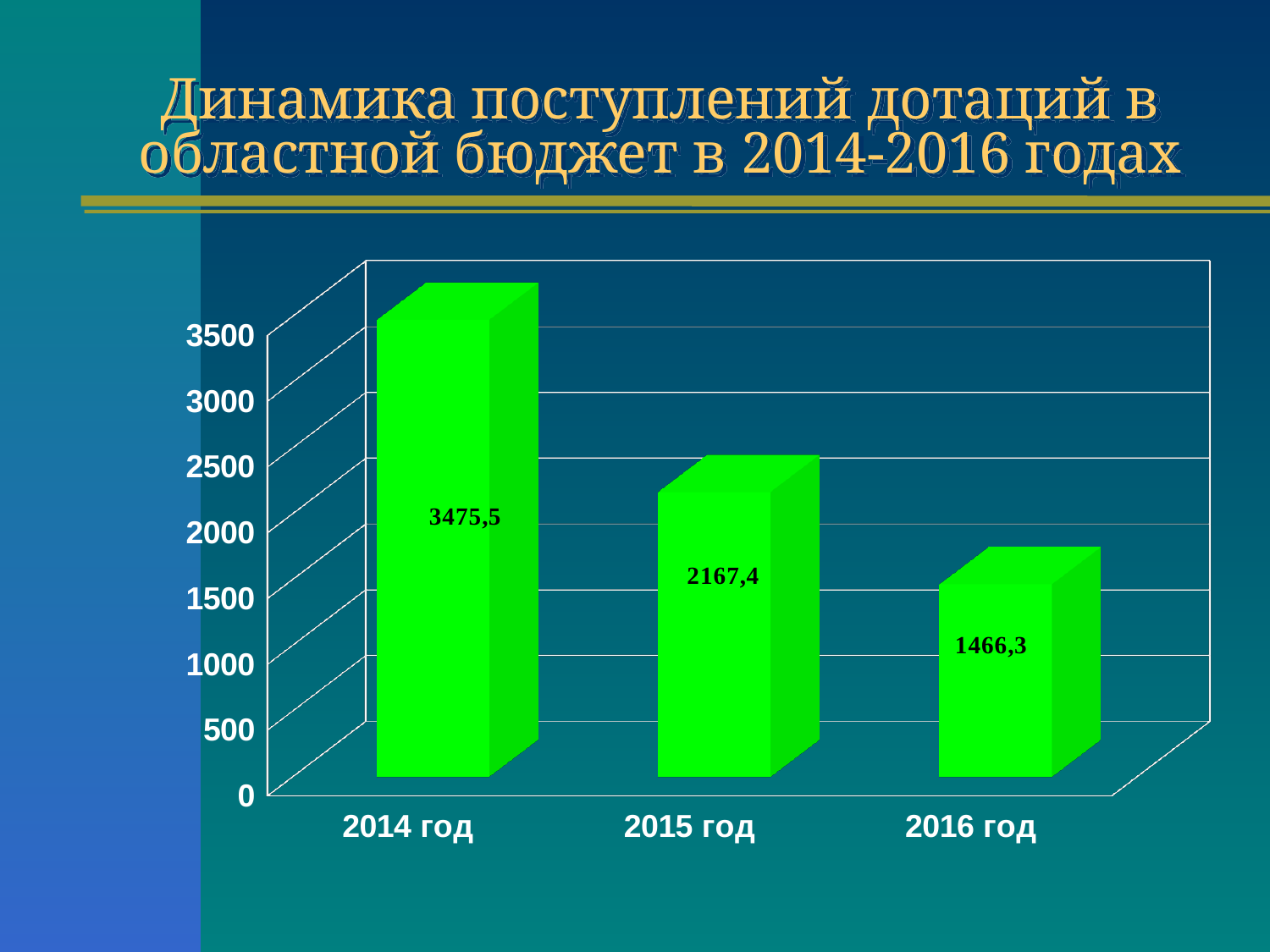
Which year has the highest value? 2014 год What is the difference between the values for 2015 год and 2016 год? 701,1 Which is larger, the value for 2015 год or the value for 2016 год? 2015 год What is the difference between the values for 2014 год and 2015 год? 1308,1 What kind of chart is shown on the slide? bar chart What is the value shown for 2014 год? 3475,5 What is the value shown for 2016 год? 1466,3 Which year has the lowest value? 2016 год Do the values rise or fall from 2014 год to 2016 год? fall Is the value for 2015 год greater or less than 2000? greater How many years are shown on the chart? 3 What is the value shown for 2015 год? 2167,4